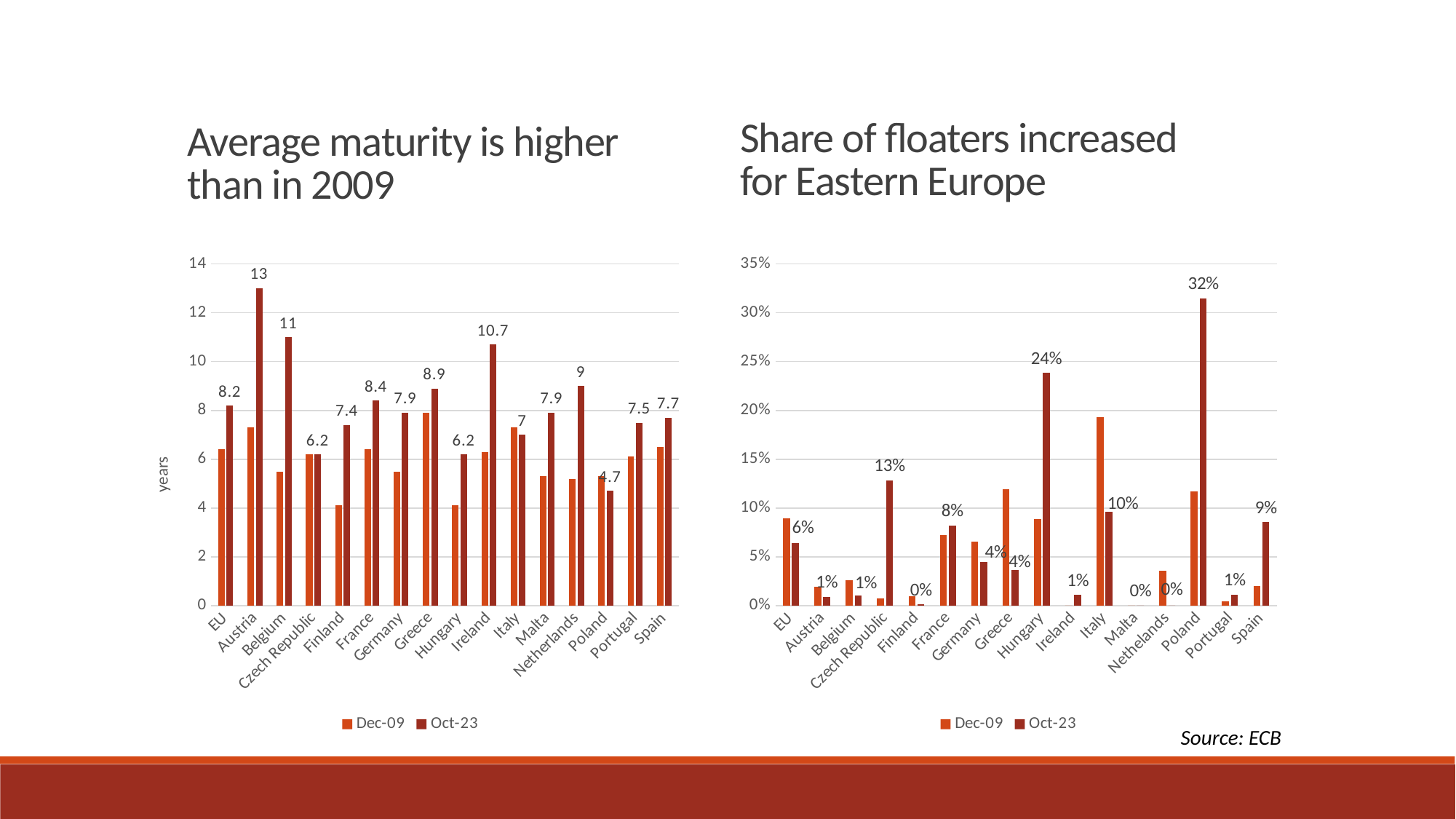
In the 'Average maturity is higher than in 2009' chart, what is the Oct-23 value for Ireland? 10.7 In the 'Average maturity is higher than in 2009' chart, what is the difference between the Oct-23 values for Belgium and Poland? 6.3 In the 'Share of floaters increased for Eastern Europe' chart, which country has the highest Oct-23 value? Poland In the 'Share of floaters increased for Eastern Europe' chart, which is larger for Oct-23: Hungary or Czech Republic? Hungary What type of chart is the 'Average maturity is higher than in 2009' chart? Bar chart In the 'Average maturity is higher than in 2009' chart, what is the Oct-23 value for Austria? 13 In the 'Average maturity is higher than in 2009' chart, is the Dec-09 value for Finland greater or less than 6? less How many countries/categories are shown on the x axis of the 'Share of floaters increased for Eastern Europe' chart? 16 In the 'Share of floaters increased for Eastern Europe' chart, what is the Oct-23 value for Poland? 32% In the 'Share of floaters increased for Eastern Europe' chart, is the Dec-09 value for Italy greater or less than 15%? greater In the 'Average maturity is higher than in 2009' chart, how many series does the legend list? 2 In the 'Average maturity is higher than in 2009' chart, which country has the lowest Oct-23 value? Poland